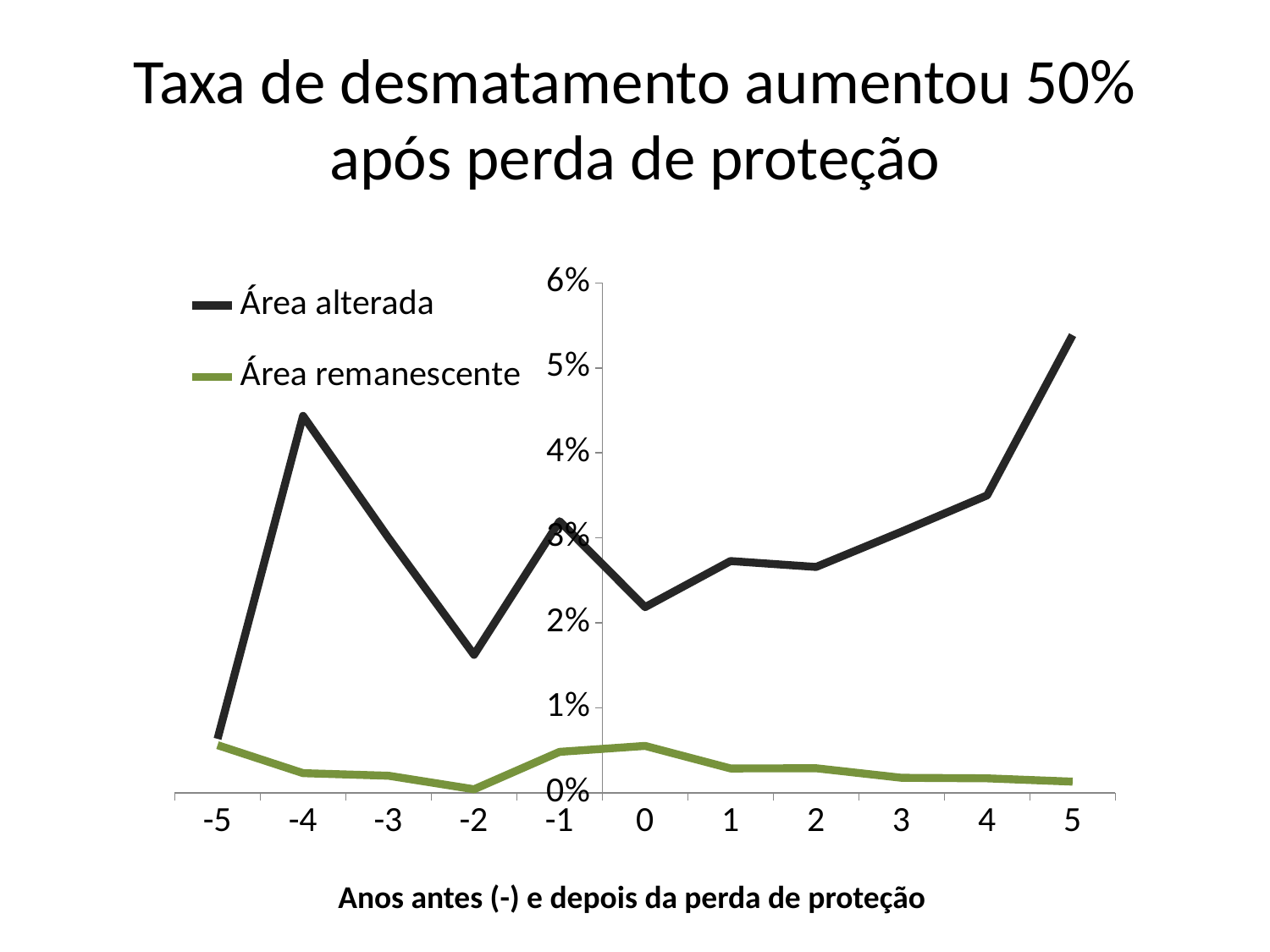
Is the value for Área alterada at year -4 greater or less than 4%? greater What kind of chart is shown on the slide? line chart How many points along the x axis does each line have? 11 Does the Área alterada line rise or fall from year 0 to year 5? rises Which is larger for Área alterada: the value at year -4 or the value at year 4? year -4 What is the x-axis title of the chart? Anos antes (-) e depois da perda de proteção Is the value for Área alterada at year -2 greater or less than 2%? less At which year is the value for Área alterada highest? 5 At which year is the value for Área remanescente lowest? -2 Is the value for Área alterada at year 5 greater or less than 5%? greater At which year is the value for Área alterada lowest? -5 How many series does the legend list? 2